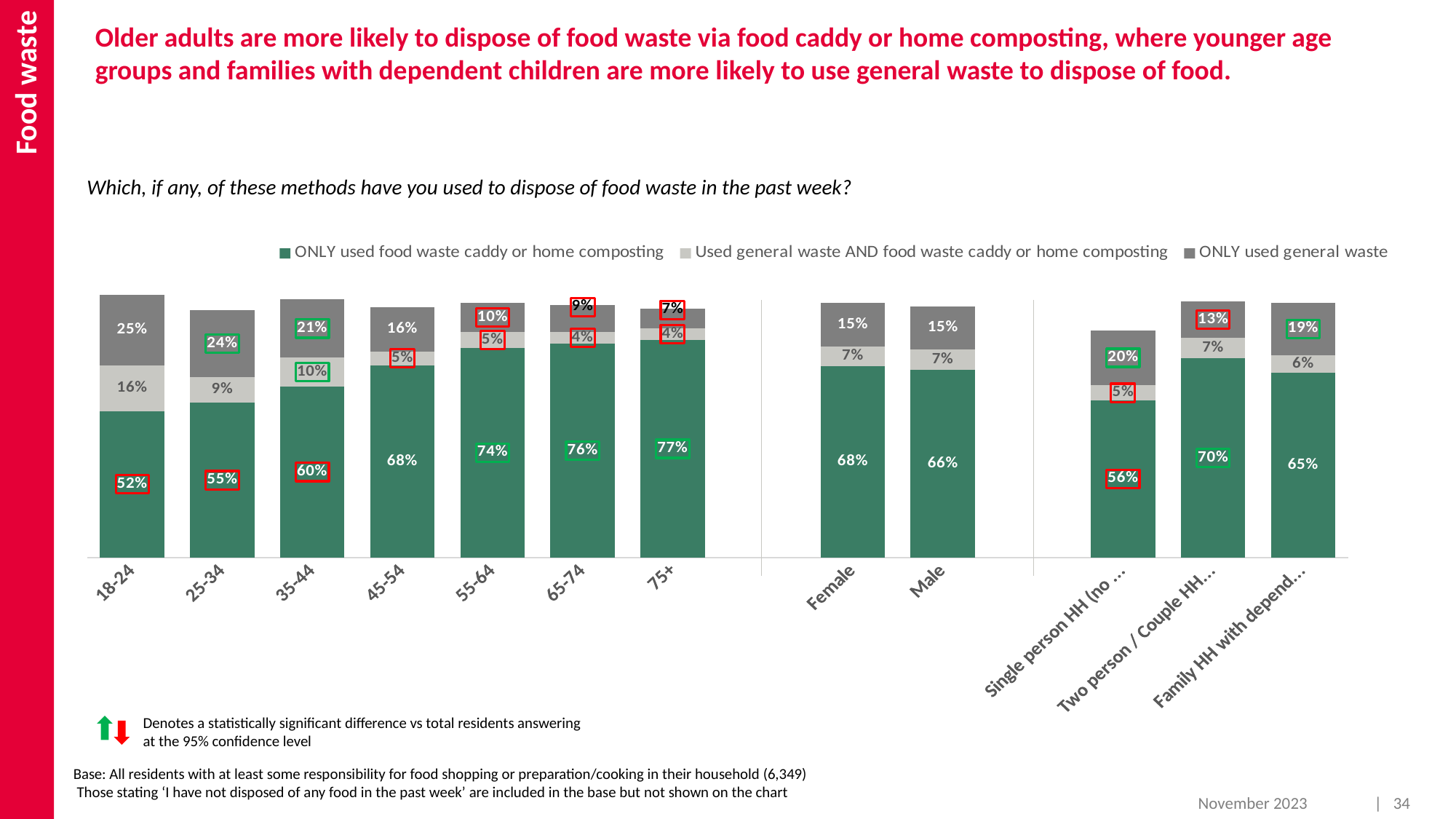
How many series does the legend list? 3 Which age group has the lowest percentage for ONLY used food waste caddy or home composting? 18-24 How many categories are shown along the x axis? 12 What percentage of Female respondents used general waste AND food waste caddy or home composting? 7% What is the total of the three stacked segments for the 45-54 age group? 89% What kind of chart is shown on the slide? Stacked bar chart What percentage of 18-24 year olds ONLY used food waste caddy or home composting? 52% Across the age groups from 18-24 to 75+, does the percentage for ONLY used food waste caddy or home composting rise or fall? Rise What is the difference between the ONLY used general waste percentages for 18-24 and 75+? 18 percentage points Which age group has the highest percentage for ONLY used food waste caddy or home composting? 75+ What percentage of the 75+ age group ONLY used general waste? 7% Which has a higher percentage for ONLY used food waste caddy or home composting, Female or Male? Female